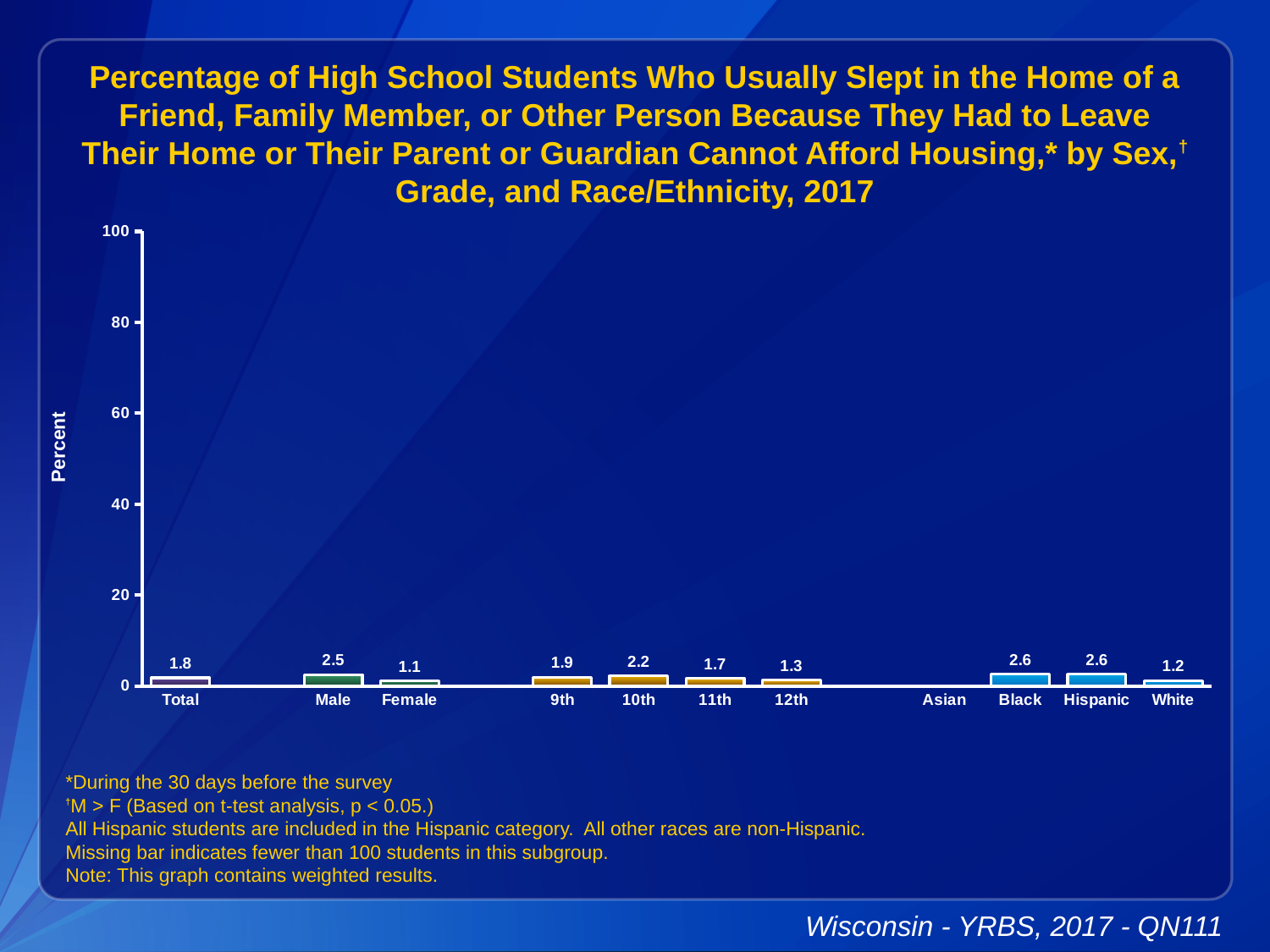
What is the difference between the values for Male and Female? 1.4 What is the value for Male? 2.5 What is the value for Total? 1.8 How many category labels are shown on the x axis? 11 Is the value for Black greater or less than 20? less What is the value for White? 1.2 What is the value for 10th grade? 2.2 What is the difference between the values for 9th grade and 12th grade? 0.6 Which is larger, the value for Male or the value for Female? Male What is the value for Female? 1.1 What kind of chart is shown on the slide? bar chart Which is larger, the value for 10th grade or the value for 12th grade? 10th